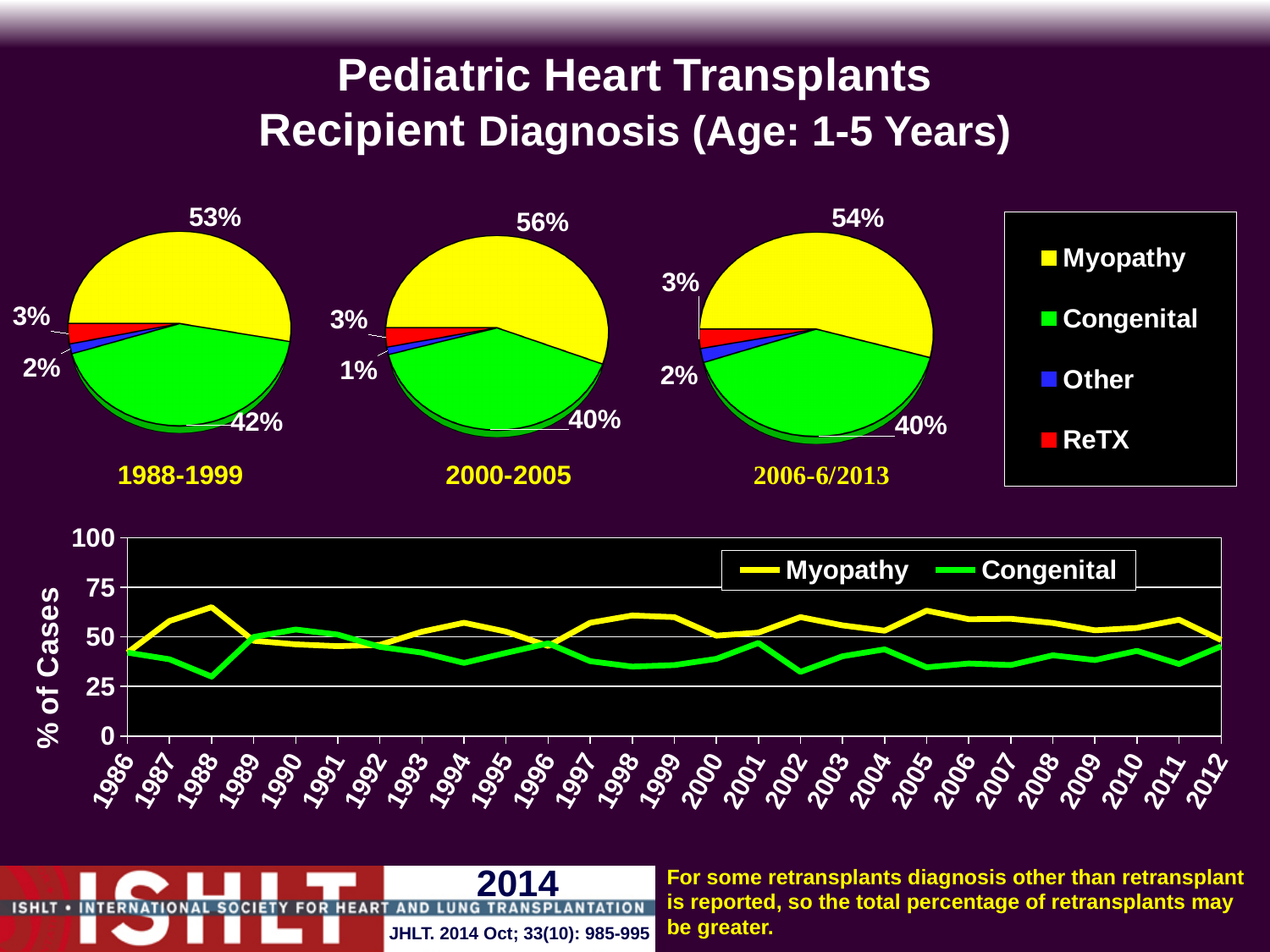
In the line chart at the bottom, is the Myopathy value for 1988 greater or less than 50? greater In the line chart at the bottom, how many series does the legend list? 2 How many categories does the pie chart legend list? 4 In the 2006-6/2013 pie chart, what percentage is ReTX? 3% In the 2006-6/2013 pie chart, what is the difference between the Myopathy and Congenital shares? 14% What type of chart is shown at the bottom of the slide? line chart In the 1988-1999 pie chart, what percentage is Myopathy? 53% In the 2000-2005 pie chart, which category has the smallest share? Other In the line chart at the bottom, is the Congenital value for 2002 greater or less than 50? less In the 1988-1999 pie chart, which category has the largest share? Myopathy Which pie chart shows the higher Myopathy share, 1988-1999 or 2000-2005? 2000-2005 In the 2000-2005 pie chart, what percentage is Congenital? 40%